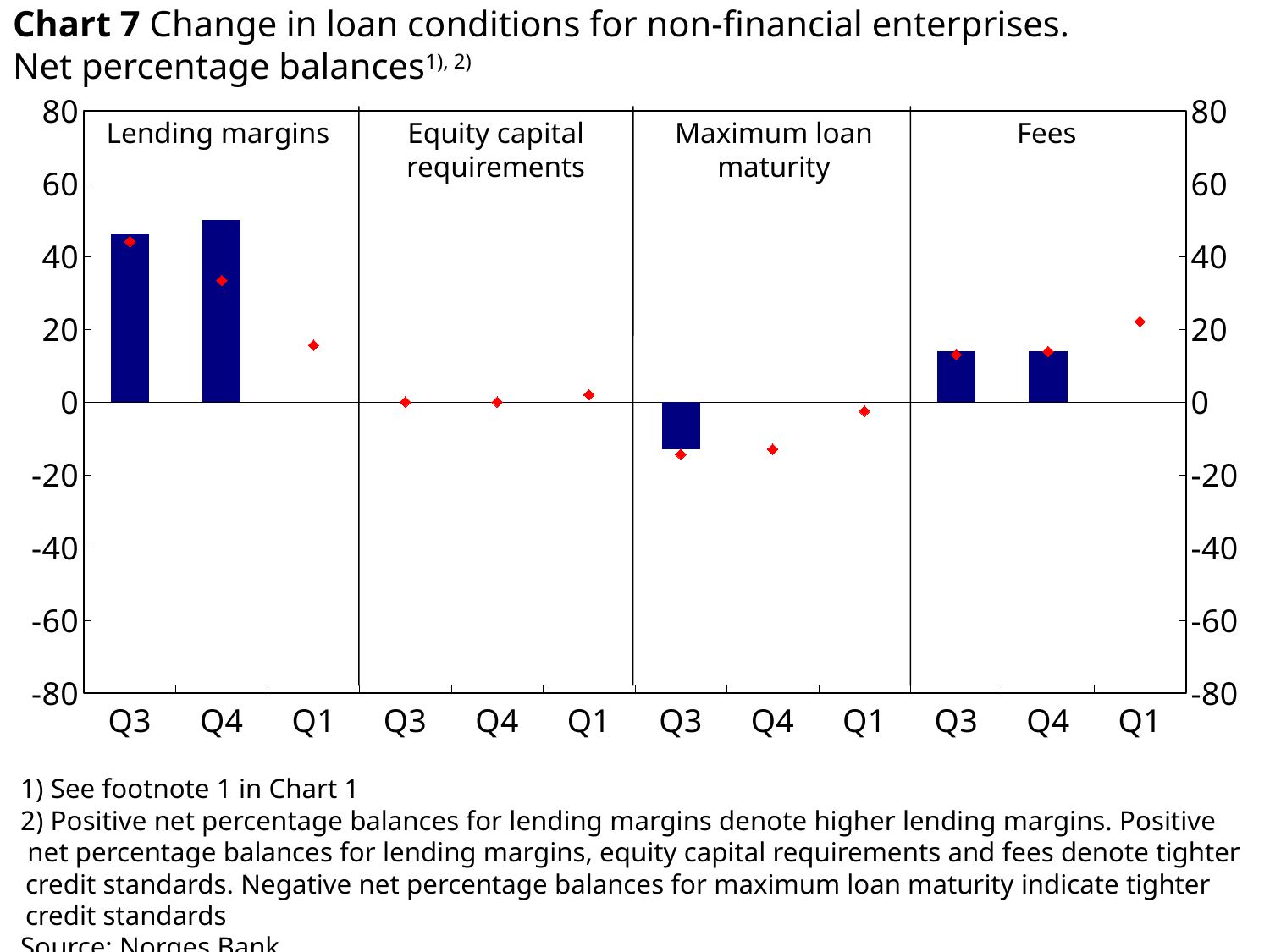
What kind of chart is shown on the slide? bar chart Which loan condition panel contains the highest bar in the chart? Lending margins How many quarters are shown on the x axis within each panel? 3 Which is larger, the Q3 bar for Lending margins or the Q3 bar for Fees? Lending margins Is the Q3 bar for Maximum loan maturity greater or less than -20? greater What is the source given for the chart? Norges Bank Is the Q3 bar for Maximum loan maturity greater or less than 0? less Which loan condition panel is the only one with a negative bar? Maximum loan maturity How many loan condition panels does the chart show? 4 Is the Q1 marker for Lending margins greater or less than 20? less